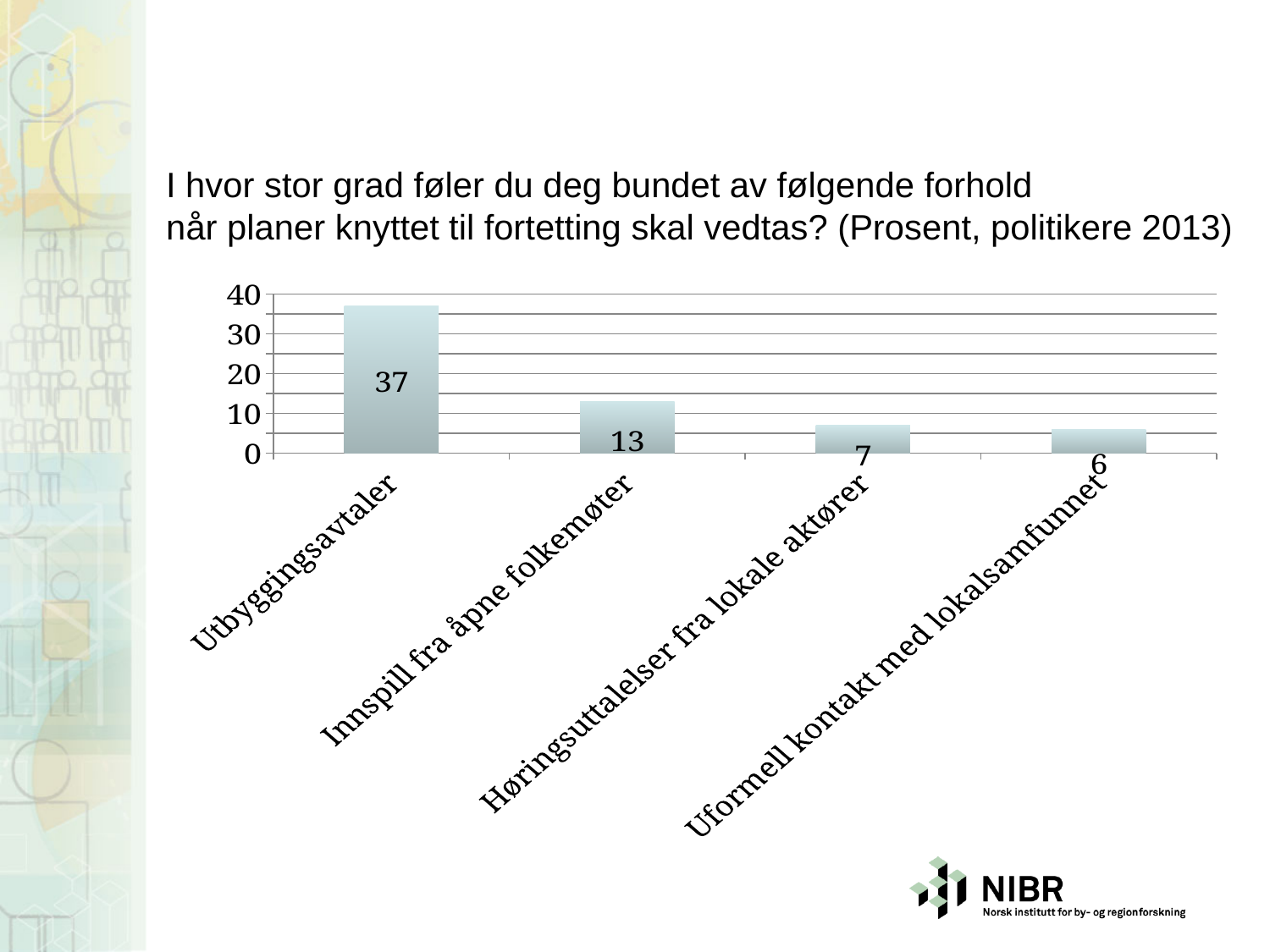
Do the values rise or fall from left to right along the x axis? fall What kind of chart is shown on the slide? bar chart Which category has the highest value? Utbyggingsavtaler What is the value for Uformell kontakt med lokalsamfunnet? 6 What is the value for Innspill fra åpne folkemøter? 13 Is the value for Utbyggingsavtaler greater or less than 30? greater What is the value for Høringsuttalelser fra lokale aktører? 7 How many categories are shown in the chart? 4 Which category has the lowest value? Uformell kontakt med lokalsamfunnet Which is larger, the value for Innspill fra åpne folkemøter or the value for Høringsuttalelser fra lokale aktører? Innspill fra åpne folkemøter What is the difference between the values for Utbyggingsavtaler and Innspill fra åpne folkemøter? 24 What is the value for Utbyggingsavtaler? 37